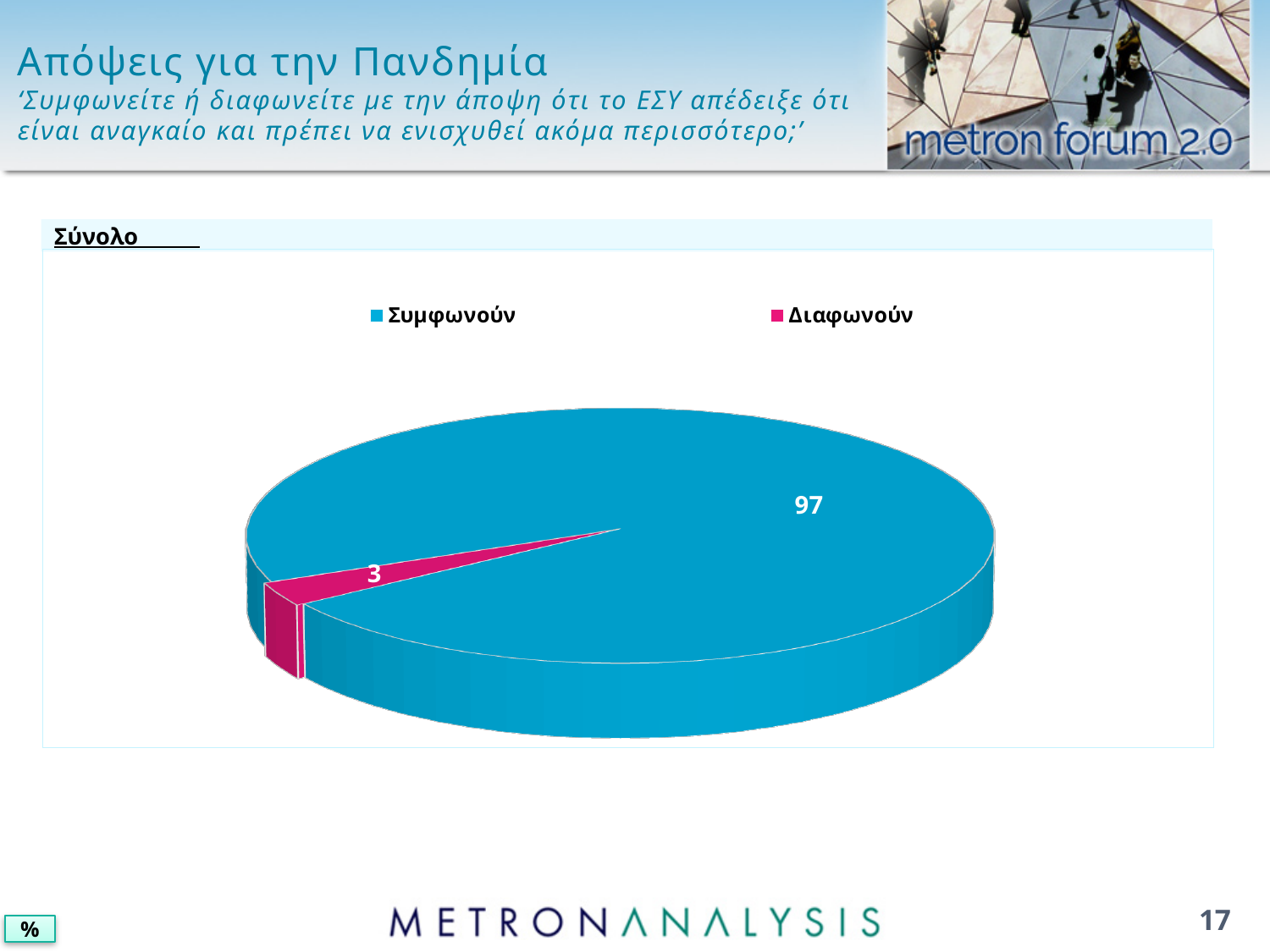
What value is shown for Διαφωνούν in the pie chart? 3 What is the difference between the values for Συμφωνούν and Διαφωνούν? 94 How many entries does the legend list? 2 How many slices does the pie chart have? 2 Which category has the largest slice in the pie chart? Συμφωνούν What colour is the Συμφωνούν slice in the pie chart? Blue What kind of chart is shown on the slide? Pie chart What share of the pie does the Διαφωνούν slice represent? 3% Which category has the smallest slice in the pie chart? Διαφωνούν What is the label above the chart box? Σύνολο What value is shown for Συμφωνούν in the pie chart? 97 Which is larger, the value for Συμφωνούν or the value for Διαφωνούν? Συμφωνούν